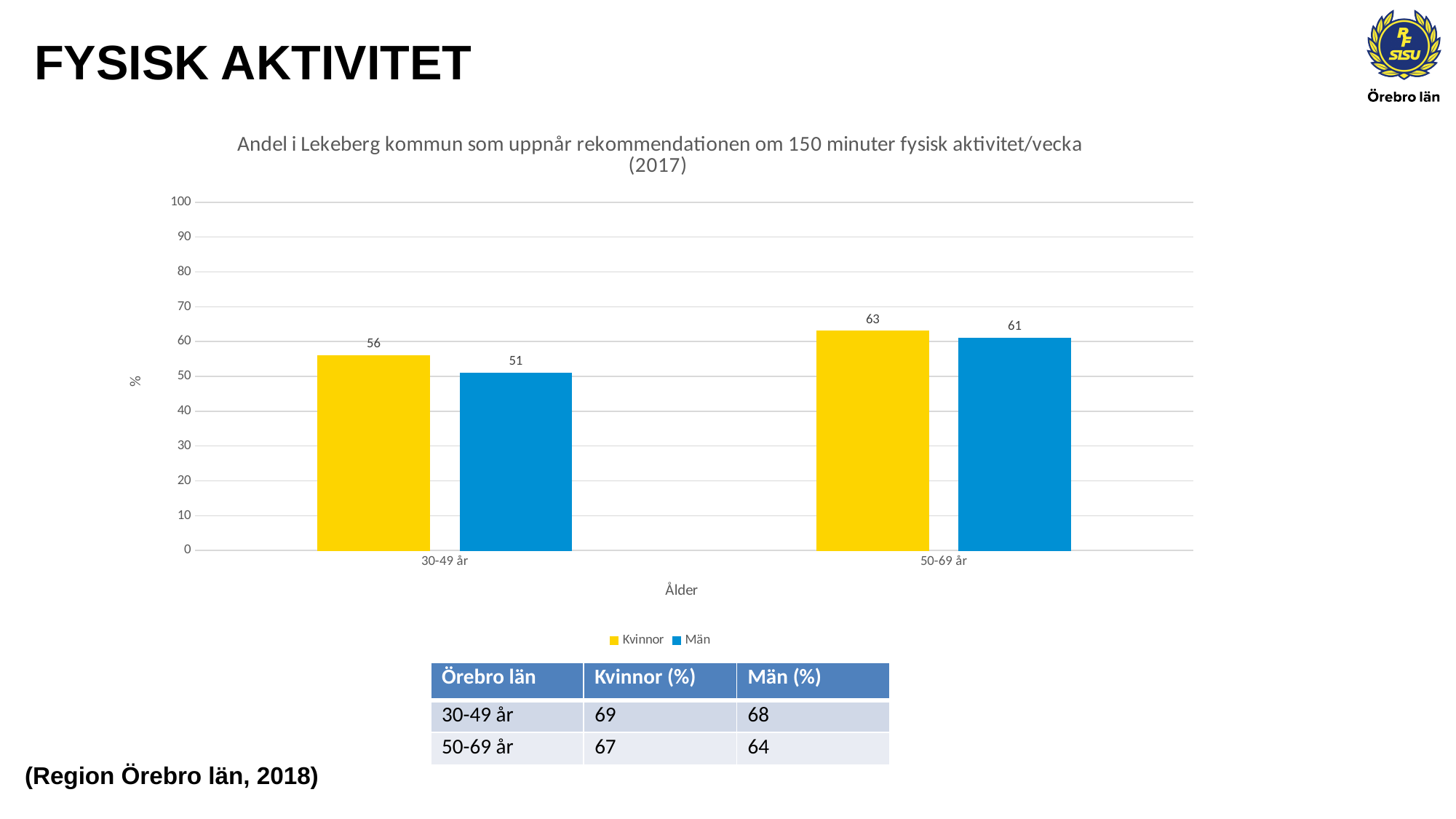
Is the value for Män in the 50-69 år category greater or less than 70? less What kind of chart is shown on the slide? bar chart What is the value for Män in the 50-69 år category? 61 Which age group has the highest value for Kvinnor? 50-69 år How many age categories are shown on the x axis? 2 What is the difference between the Kvinnor values for 50-69 år and 30-49 år? 7 What is the difference between Kvinnor and Män in the 30-49 år category? 5 What is the value for Kvinnor in the 30-49 år category? 56 Which bar has the lowest value in the chart? Män, 30-49 år How many series does the legend list? 2 What is the value for Män in the 30-49 år category? 51 Which is larger in the 50-69 år category, Kvinnor or Män? Kvinnor